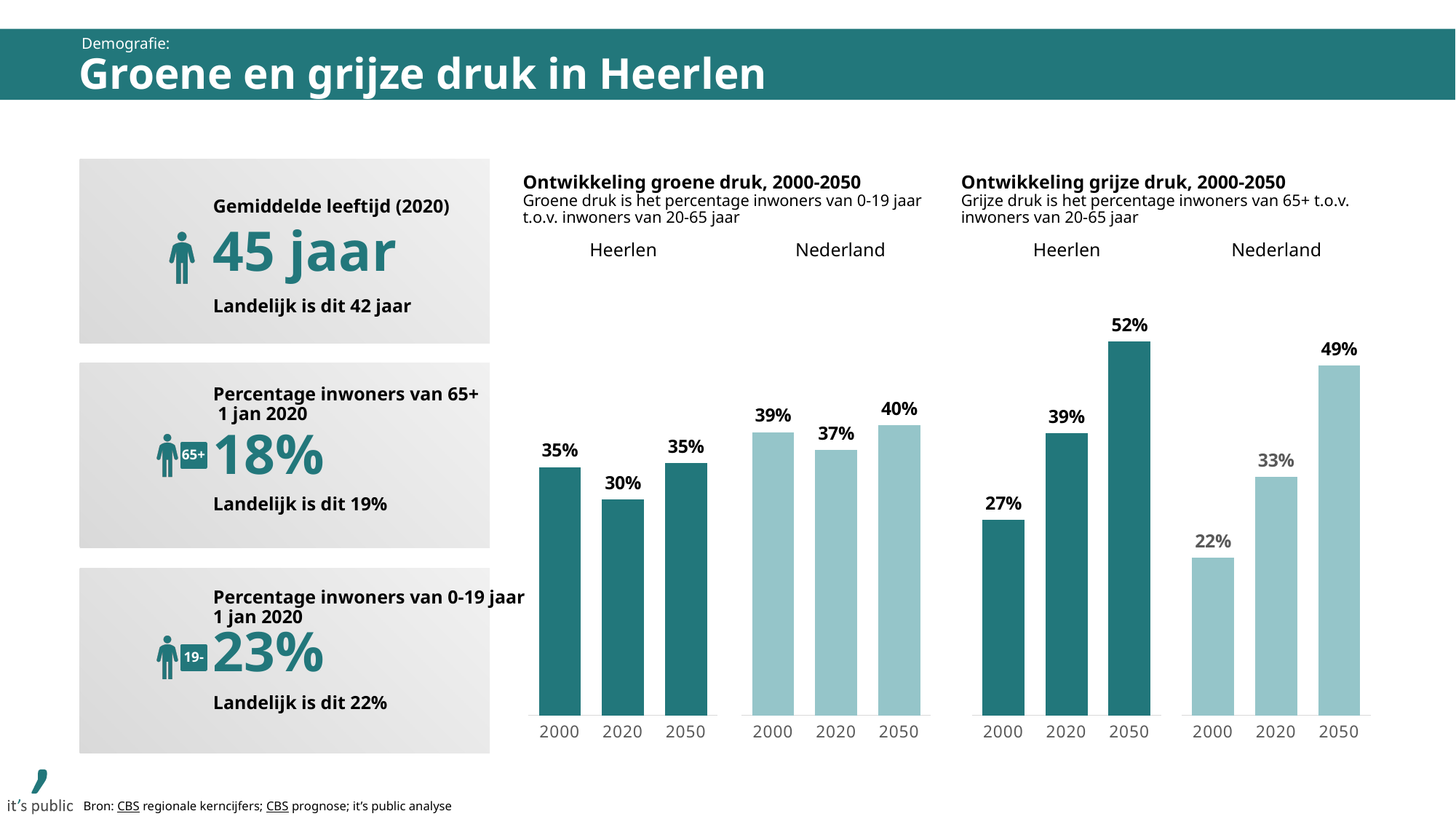
In the 'Ontwikkeling grijze druk, 2000-2050' chart, which bar is the lowest? Nederland 2000 In the 'Ontwikkeling grijze druk, 2000-2050' chart, what is the value for Heerlen in 2050? 52% In the 'Ontwikkeling groene druk, 2000-2050' chart, what is the value for Nederland in 2050? 40% In the 'Ontwikkeling grijze druk, 2000-2050' chart, what is the value for Nederland in 2000? 22% In the 'Ontwikkeling grijze druk, 2000-2050' chart, what is the difference between Heerlen in 2050 and Heerlen in 2000? 25% In the 'Ontwikkeling grijze druk, 2000-2050' chart, which is larger: Heerlen in 2020 or Nederland in 2020? Heerlen in 2020 In the 'Ontwikkeling grijze druk, 2000-2050' chart, do the values for Heerlen rise or fall from 2000 to 2050? rise What kind of chart is 'Ontwikkeling grijze druk, 2000-2050'? bar chart In the 'Ontwikkeling groene druk, 2000-2050' chart, what is the value for Heerlen in 2020? 30% How many bars are shown in the 'Ontwikkeling groene druk, 2000-2050' chart? 6 In the 'Ontwikkeling groene druk, 2000-2050' chart, what is the difference between Nederland in 2000 and Heerlen in 2000? 4% In the 'Ontwikkeling groene druk, 2000-2050' chart, which bar is the highest? Nederland 2050